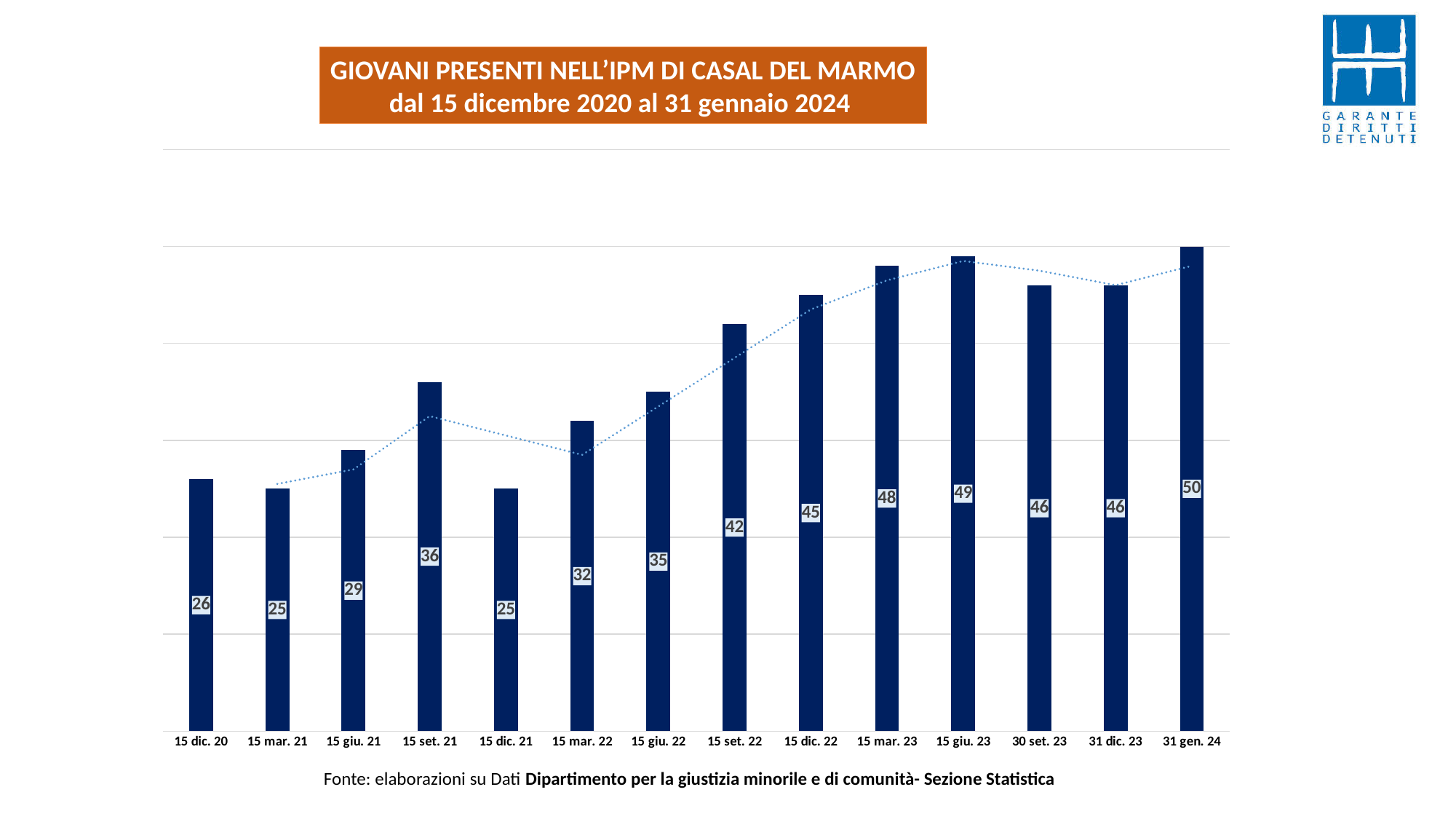
What is the title of the chart? GIOVANI PRESENTI NELL'IPM DI CASAL DEL MARMO dal 15 dicembre 2020 al 31 gennaio 2024 What is the difference between the values for 15 giu. 23 and 30 set. 23? 3 How many dates are shown along the x axis of the chart? 14 What is the value for 15 set. 21? 36 What kind of chart is shown on the slide? bar chart What is the lowest value shown in the chart? 25 Do the values generally rise or fall from 15 dic. 21 to 15 giu. 23? rise Which is larger, the value for 15 set. 21 or the value for 15 mar. 22? 15 set. 21 Which date has the highest value? 31 gen. 24 What is the value for 31 gen. 24? 50 What is the value for 15 dic. 22? 45 What is the difference between the values for 31 gen. 24 and 15 dic. 20? 24